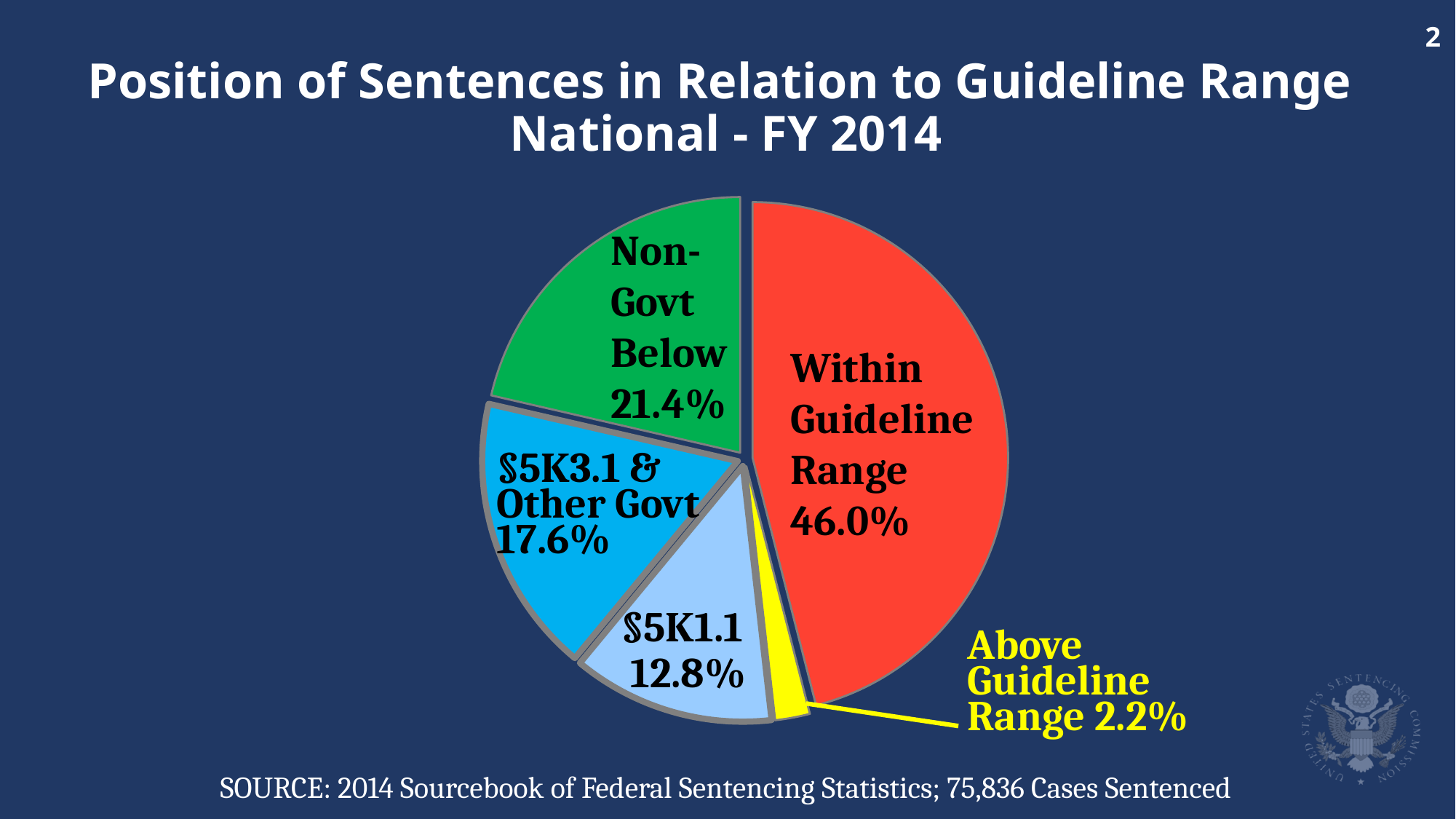
Which slice of the pie is the smallest? Above Guideline Range What share of sentences were §5K3.1 & Other Govt? 17.6% What is the difference in percentage points between Non-Govt Below and §5K1.1? 8.6 Which slice of the pie is the largest? Within Guideline Range Which is larger, the §5K3.1 & Other Govt slice or the §5K1.1 slice? §5K3.1 & Other Govt What share of sentences were §5K1.1? 12.8% What share of sentences were Non-Govt Below? 21.4% What colour is the Within Guideline Range slice? red What share of sentences were Within Guideline Range? 46.0% What kind of chart is shown on the slide? pie chart How many slices does the pie chart have? 5 What share of sentences were Above Guideline Range? 2.2%